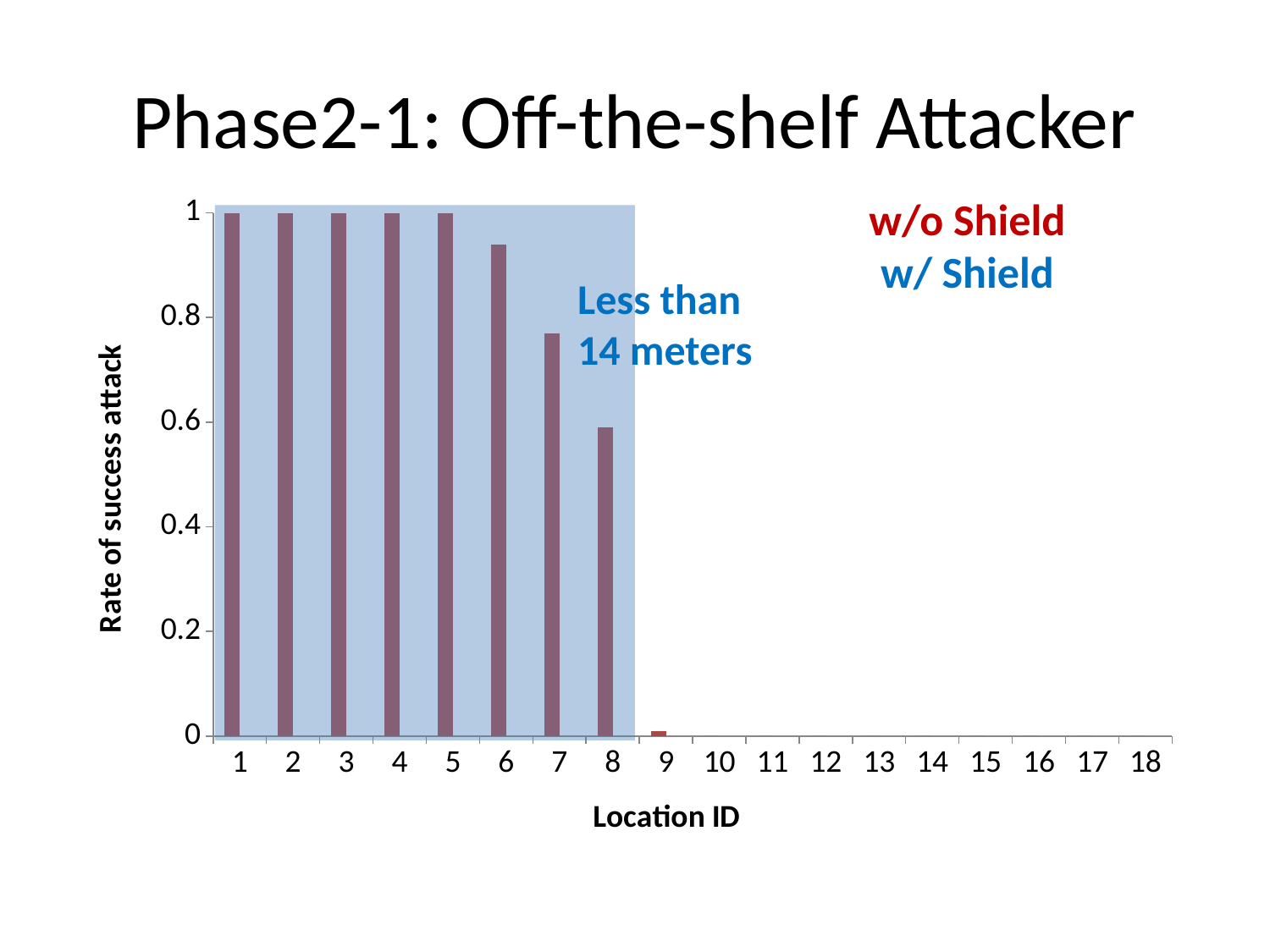
Which has a higher rate of success attack, Location ID 6 or Location ID 8? Location ID 6 Is the value for Location ID 6 greater or less than 0.8? greater What kind of chart is shown on the slide? bar chart Which has a higher rate of success attack, Location ID 7 or Location ID 8? Location ID 7 Do the values rise or fall as the Location ID increases from 5 to 9? fall Is the value for Location ID 7 greater or less than 0.8? less What is the title of the y axis? Rate of success attack What is the rate of success attack for Location ID 1? 1 How many Location IDs are shown on the x axis? 18 What is the rate of success attack for Location ID 5? 1 Is the value for Location ID 9 greater or less than 0.2? less